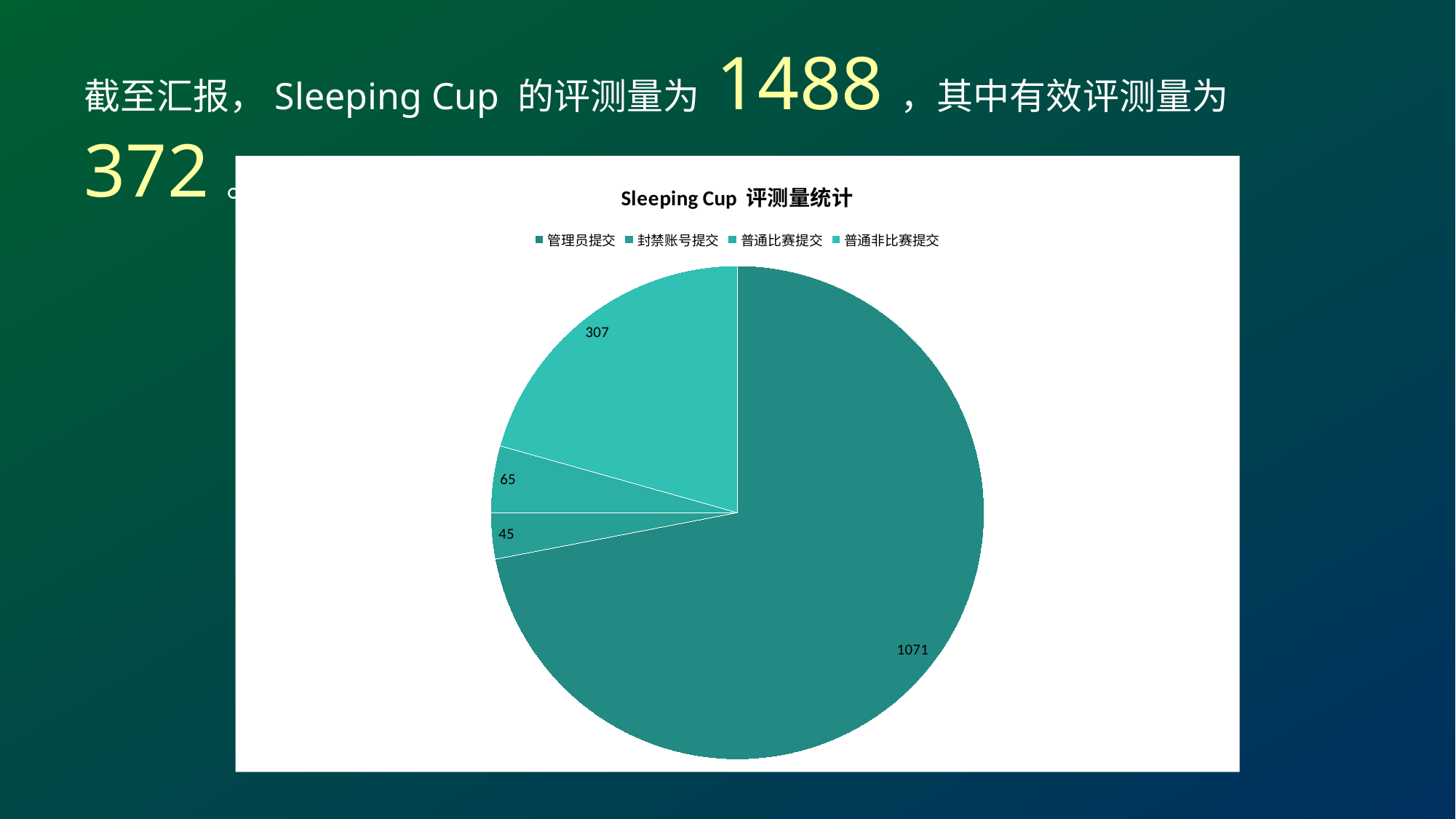
What is the total of all four slices in the pie chart? 1488 Which category has the smallest slice of the pie? 封禁账号提交 What is the value of the 普通比赛提交 slice? 65 Which is larger, the 普通比赛提交 slice or the 封禁账号提交 slice? 普通比赛提交 How many categories does the legend of the pie chart list? 4 What is the title of the chart? Sleeping Cup 评测量统计 What kind of chart is shown on the slide? pie chart What is the value of the 普通非比赛提交 slice? 307 What is the value of the 封禁账号提交 slice? 45 What is the difference between the 管理员提交 value and the 普通非比赛提交 value? 764 What is the value of the 管理员提交 slice? 1071 Which category has the largest slice of the pie? 管理员提交